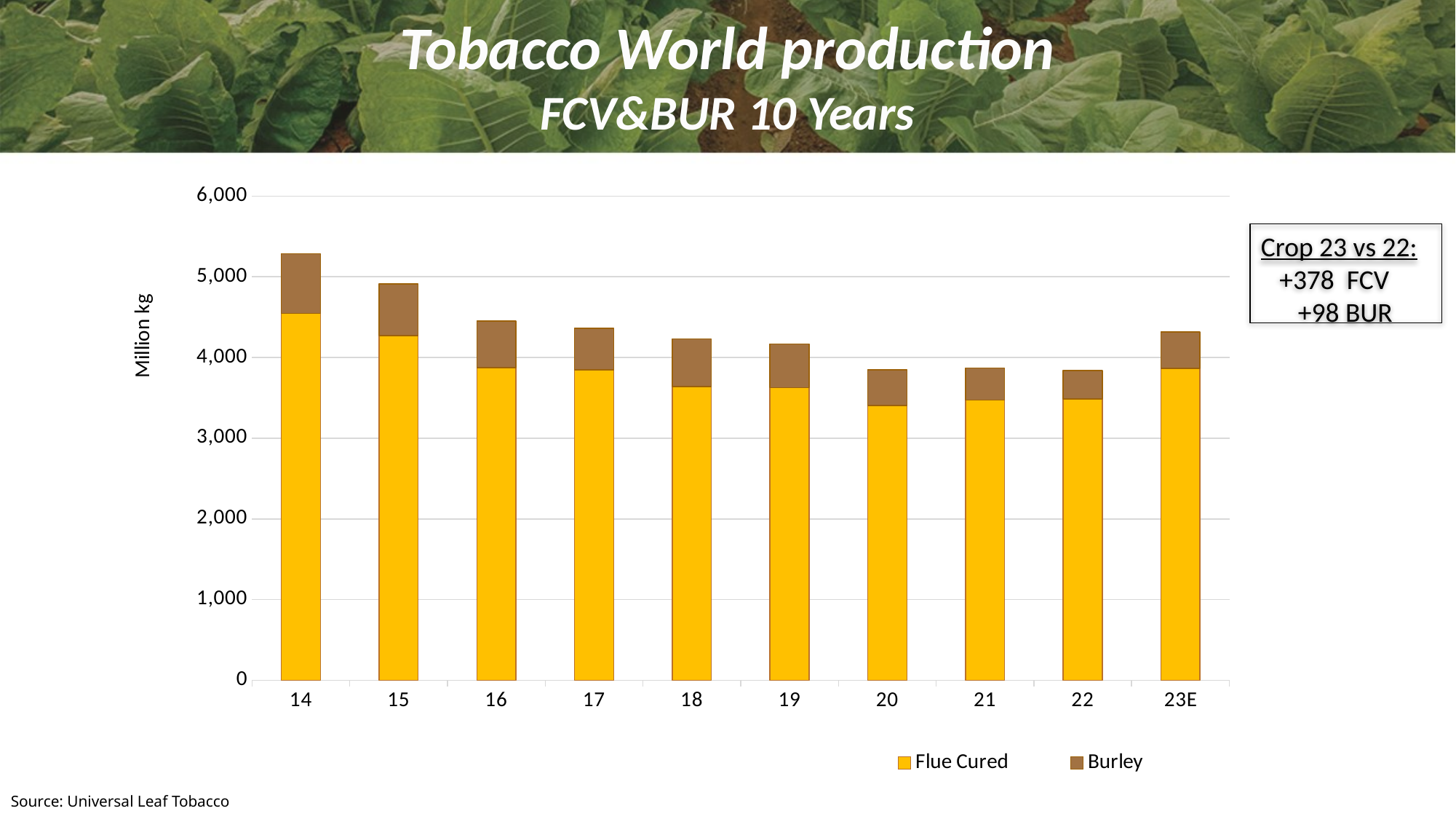
What unit is shown on the y axis label? Million kg Is the Flue Cured value for 20 greater or less than 4,000? less Which is larger, the total production for 14 or for 23E? 14 Does total production generally rise or fall from 14 to 22? fall How many years (categories) are shown on the x axis? 10 Is the total production for 23E greater or less than 4,000? greater Which year has the highest total production? 14 Is the total production for 14 greater or less than 5,000? greater How many series does the legend list? 2 Which year has the largest Burley segment? 14 What kind of chart is shown on the slide? Stacked bar chart